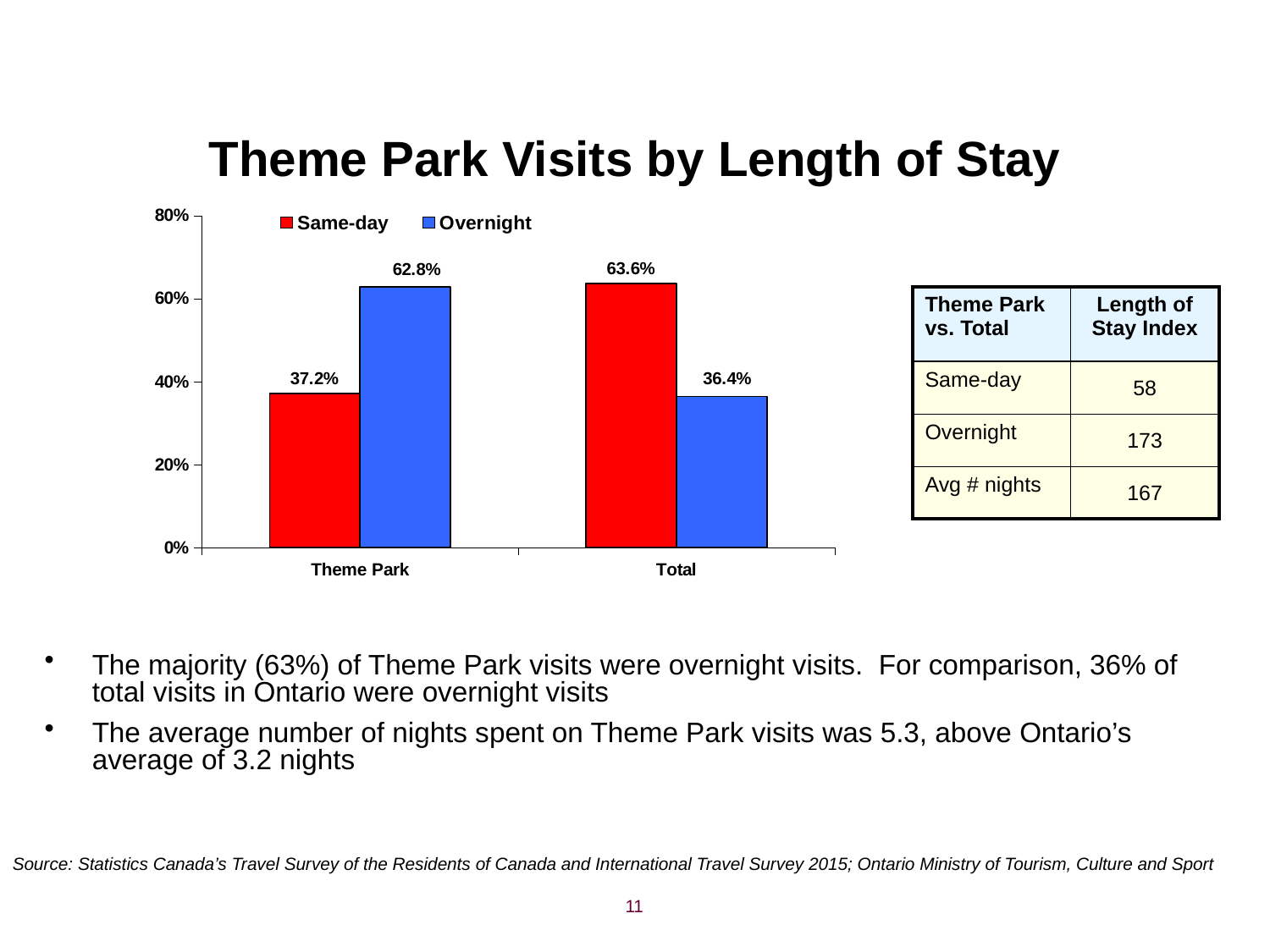
Which series has the higher value for Total, Same-day or Overnight? Same-day Which series has the higher value for Theme Park, Same-day or Overnight? Overnight What is the Same-day value for Theme Park? 37.2% What is the Same-day value for Total? 63.6% What kind of chart is shown on the slide? Bar chart How many categories are shown on the x axis? 2 What is the Overnight value for Theme Park? 62.8% What colour are the Same-day bars? Red What is the difference between the Same-day values for Total and Theme Park? 26.4% What is the Overnight value for Total? 36.4% What is the difference between the Overnight and Same-day values for Theme Park? 25.6% How many series does the legend list? 2